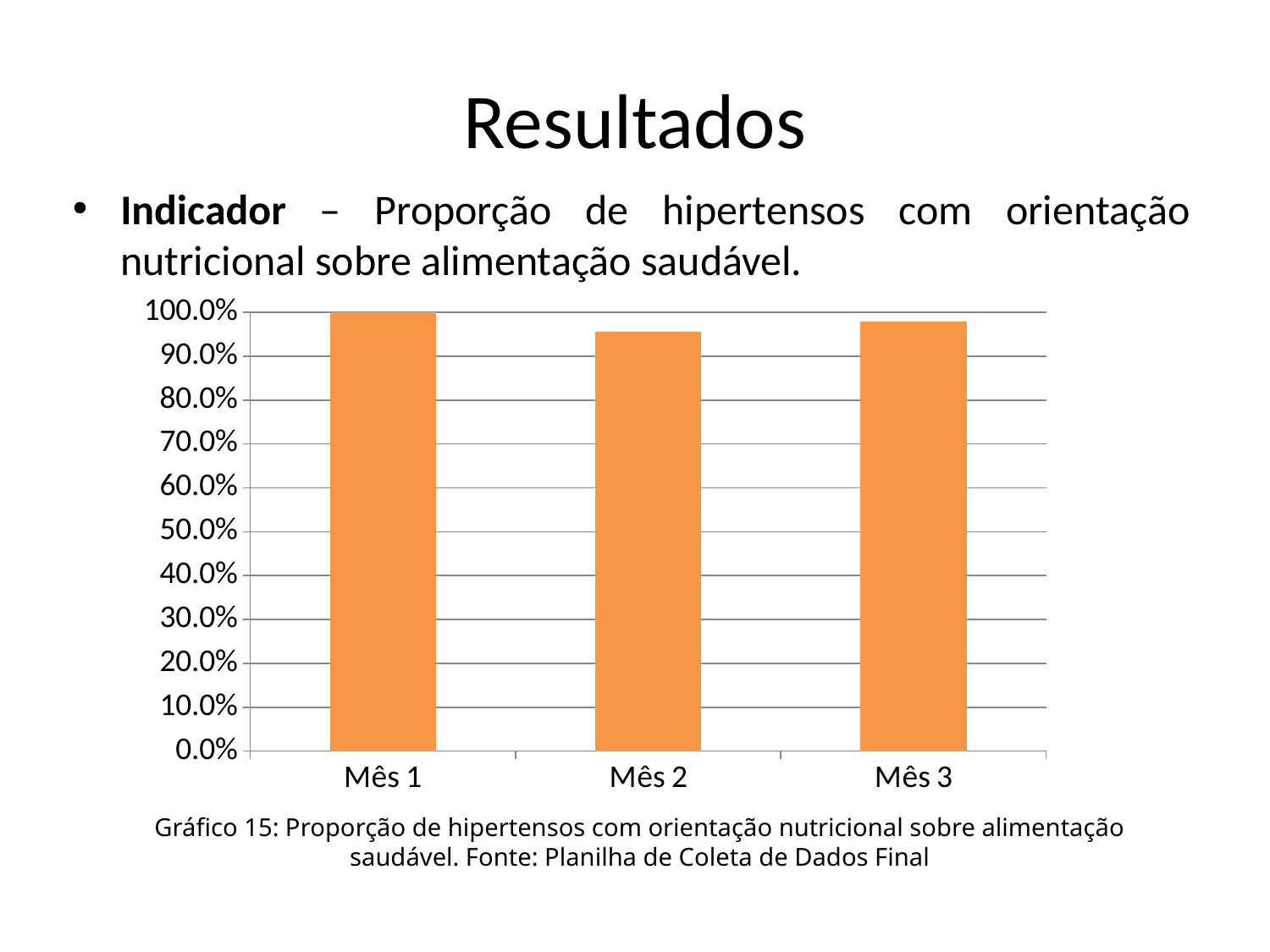
Which month has the lowest proportion on the chart? Mês 2 Is the value for Mês 2 greater or less than 100.0%? less How many categories (months) are plotted on the chart? 3 Is the value for Mês 2 greater or less than 90.0%? greater Which is larger, the value for Mês 2 or the value for Mês 3? Mês 3 Which month has the highest proportion on the chart? Mês 1 What colour are the bars on the chart? orange What is the value for Mês 1 on the chart? 100.0% What kind of chart is shown on the slide? bar chart Do the values rise or fall from Mês 1 to Mês 2? fall Is the value for Mês 3 greater or less than 90.0%? greater What is the number of the graph given in the caption below the chart? Gráfico 15